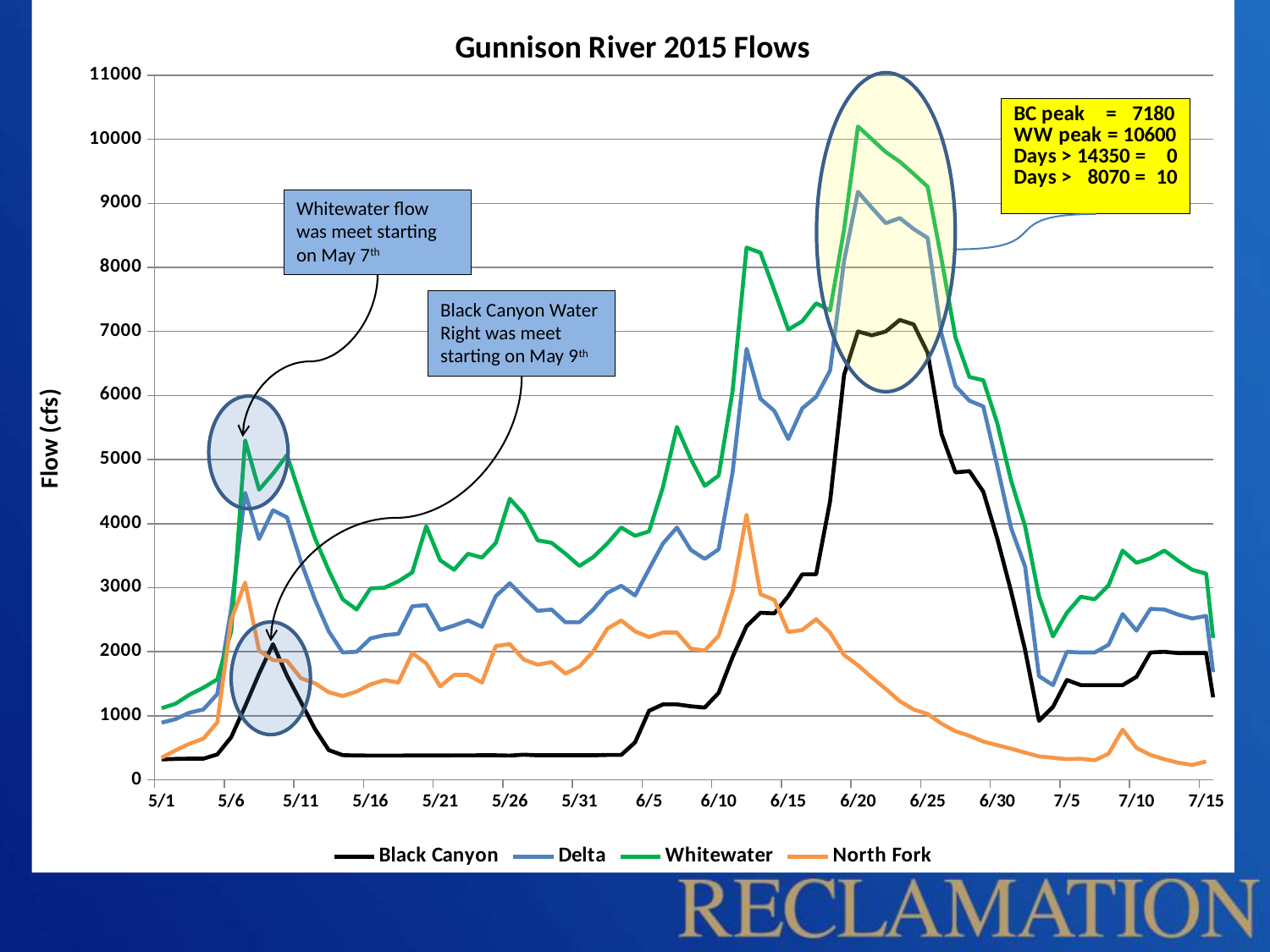
According to the text box on the chart, what is the WW peak? 10600 Which series reaches the highest flow on the chart? Whitewater According to the text box, how many days were above 8070? 10 How many series does the legend list? 4 On 6/20, which is larger, the Whitewater flow or the Black Canyon flow? Whitewater What kind of chart is shown on the slide? line chart What is the difference between the WW peak and the BC peak given in the text box? 3420 According to the text box on the chart, what is the BC peak? 7180 Is the Black Canyon flow on 5/16 greater or less than 1000? less What is the title of the chart? Gunnison River 2015 Flows Is the Whitewater flow on 6/20 greater or less than 10000? greater What is the label of the vertical axis? Flow (cfs)